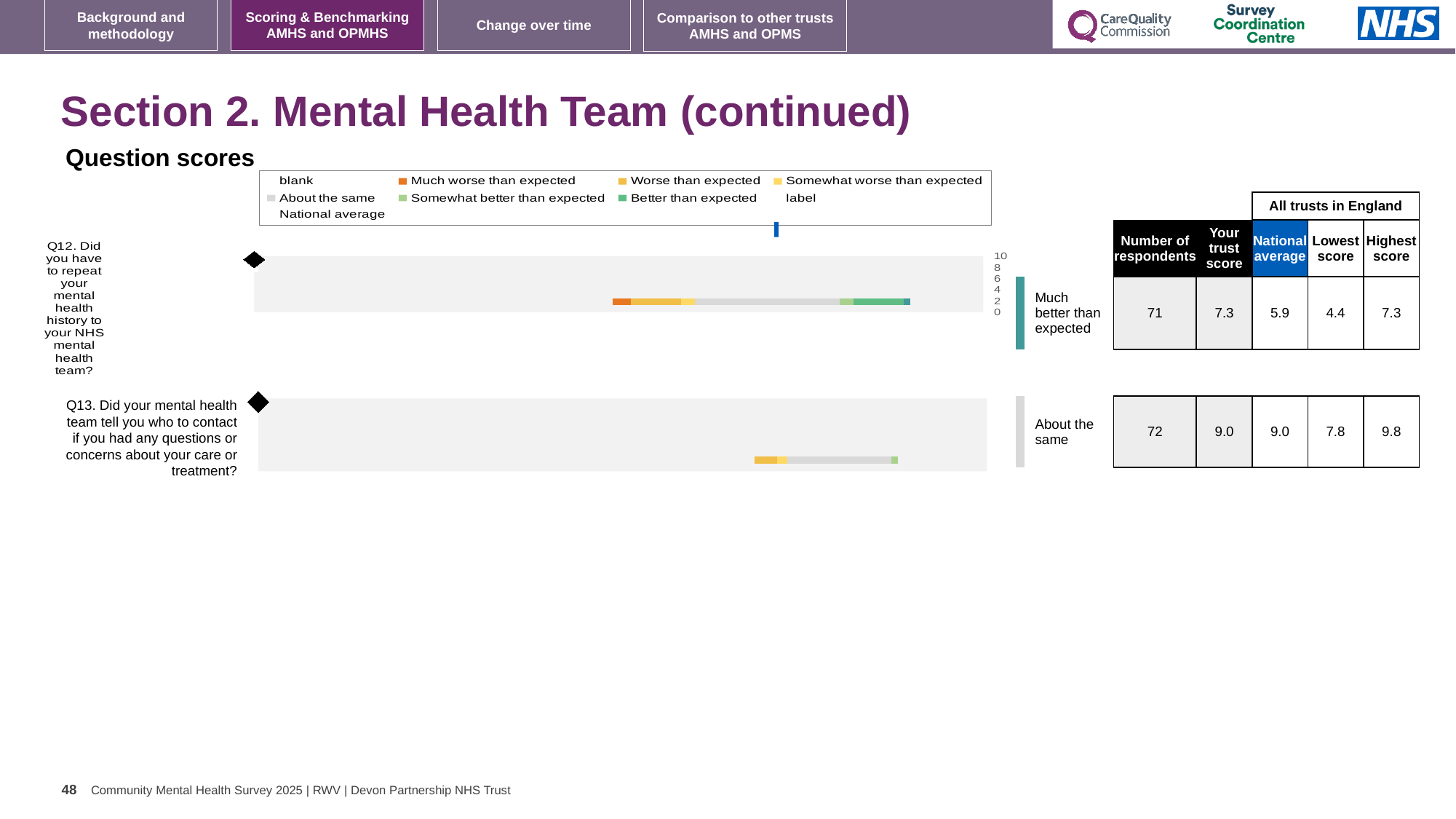
What is the difference between the trust score and the national average for Q12? 1.4 What is the national average score for Q12? 5.9 What is the lowest score among all trusts in England for Q12? 4.4 Which question has the higher 'Your trust score', Q12 or Q13? Q13 What kind of chart is used to show the Q12 and Q13 question scores? bar chart Which benchmark category is shown next to the Q13 chart? About the same What is the highest score among all trusts in England for Q13? 9.8 For Q13, is the trust score higher than, lower than, or equal to the national average? equal What is the 'Your trust score' value for Q12 (repeating mental health history)? 7.3 What is the number of respondents for Q13? 72 How many questions are charted on this slide? 2 Which benchmark category is shown next to the Q12 chart? Much better than expected